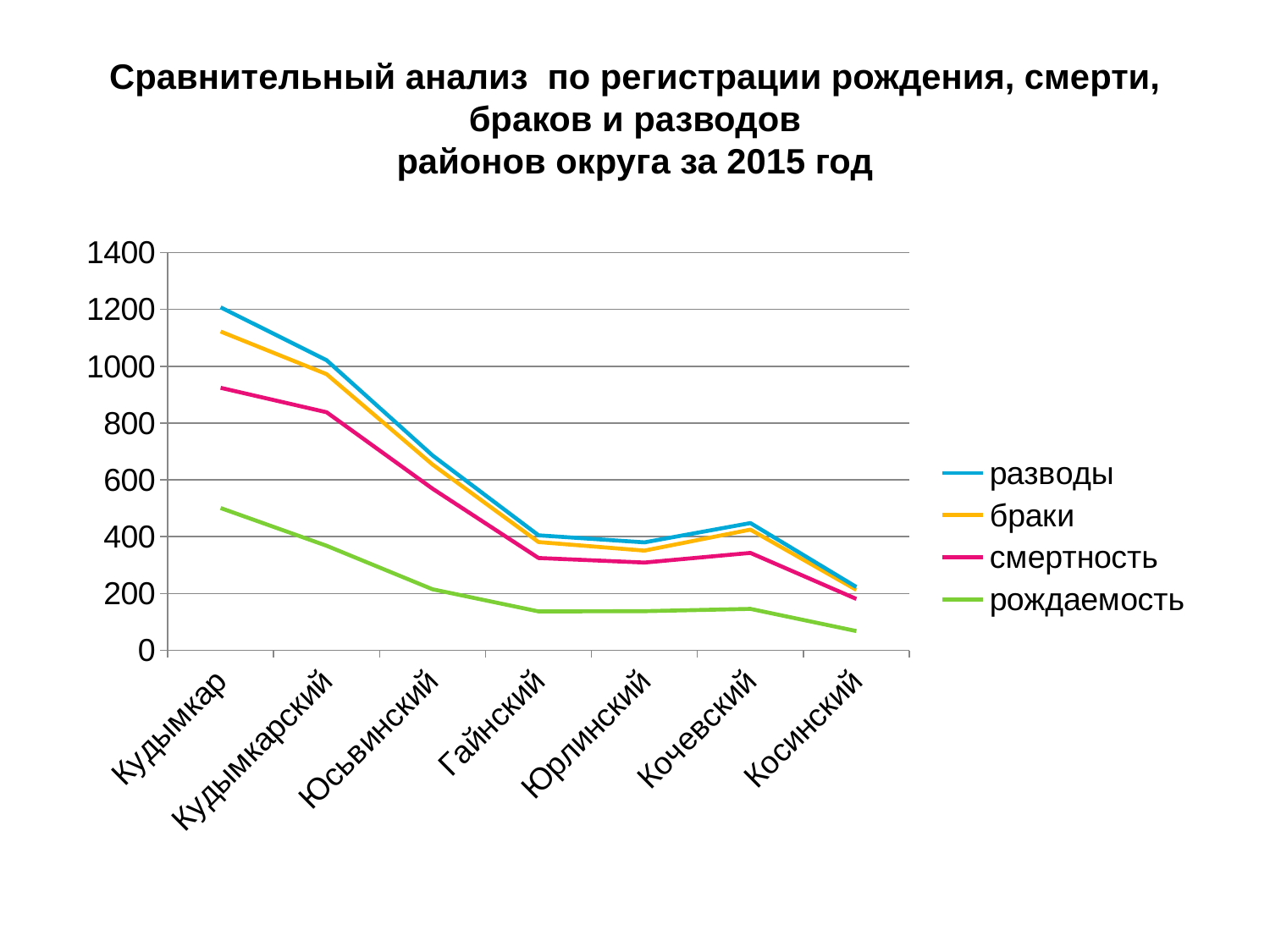
Which district has the lowest value for рождаемость? Косинский Is the value for смертность in Косинский greater or less than 400? less Which district has the highest value for разводы? Кудымкар How many districts are shown along the x axis? 7 Does the рождаемость line rise or fall from Кудымкар to Гайнский? fall Which series is drawn in green in the legend? рождаемость What kind of chart is shown on the slide? line chart Is the value for рождаемость in Кудымкар greater or less than 600? less How many series does the legend list? 4 Which is larger for браки: Кудымкар or Кудымкарский? Кудымкар